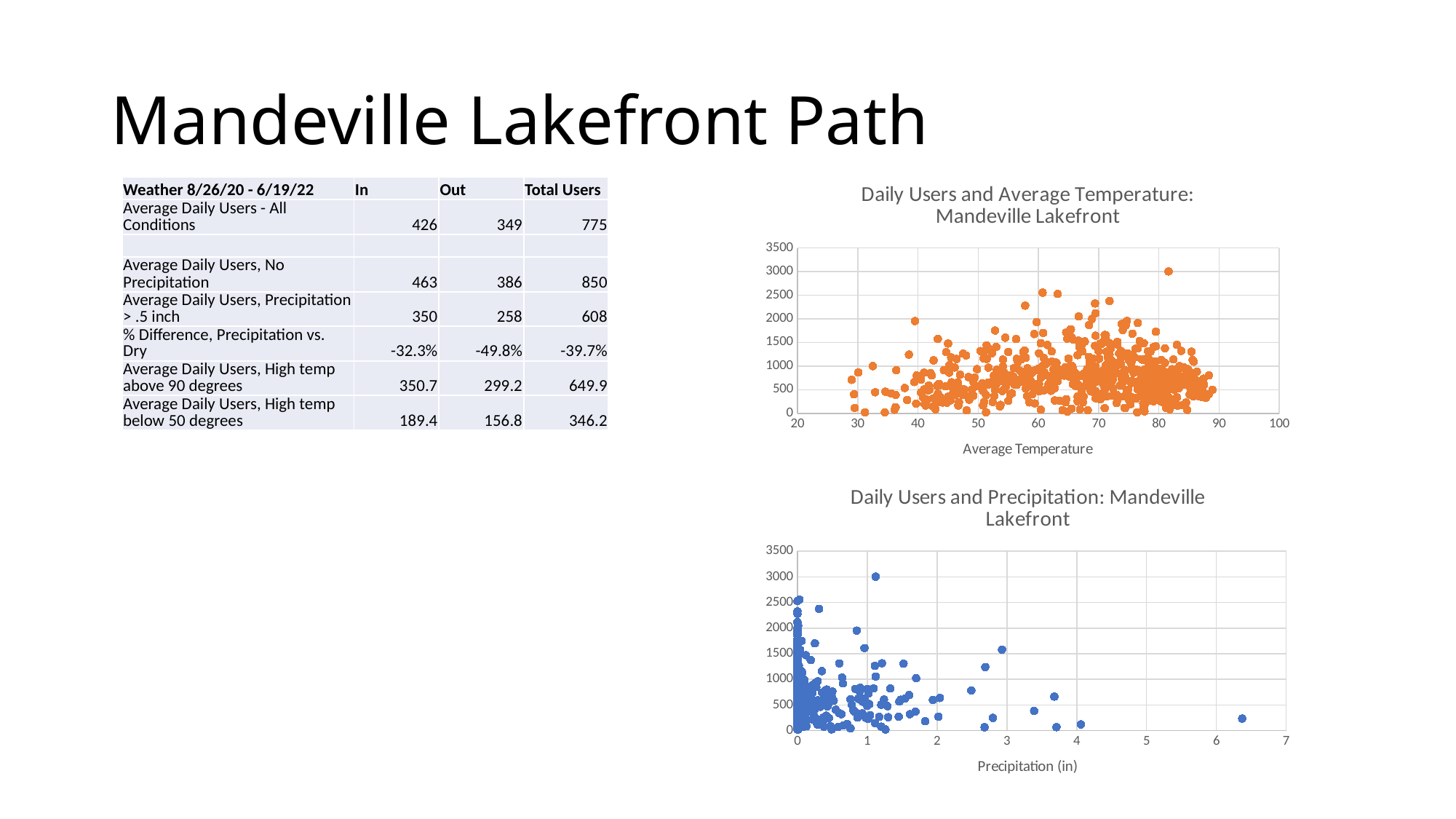
In the bottom chart, 'Daily Users and Precipitation', does the number of plotted points increase or decrease as precipitation increases along the x axis? decrease What is the title of the top chart on the slide? Daily Users and Average Temperature: Mandeville Lakefront What kind of chart is the top chart, 'Daily Users and Average Temperature: Mandeville Lakefront'? scatter chart What kind of chart is the bottom chart, 'Daily Users and Precipitation: Mandeville Lakefront'? scatter chart In the bottom chart, 'Daily Users and Precipitation', is the largest precipitation value plotted greater or less than 7? less In the top chart, 'Daily Users and Average Temperature', is the highest plotted daily users value greater or less than 2500? greater In the bottom chart, 'Daily Users and Precipitation', what is the label on the horizontal axis? Precipitation (in) In the bottom chart, 'Daily Users and Precipitation', is the daily users value of the point plotted at about 6.4 inches of precipitation greater or less than 500? less